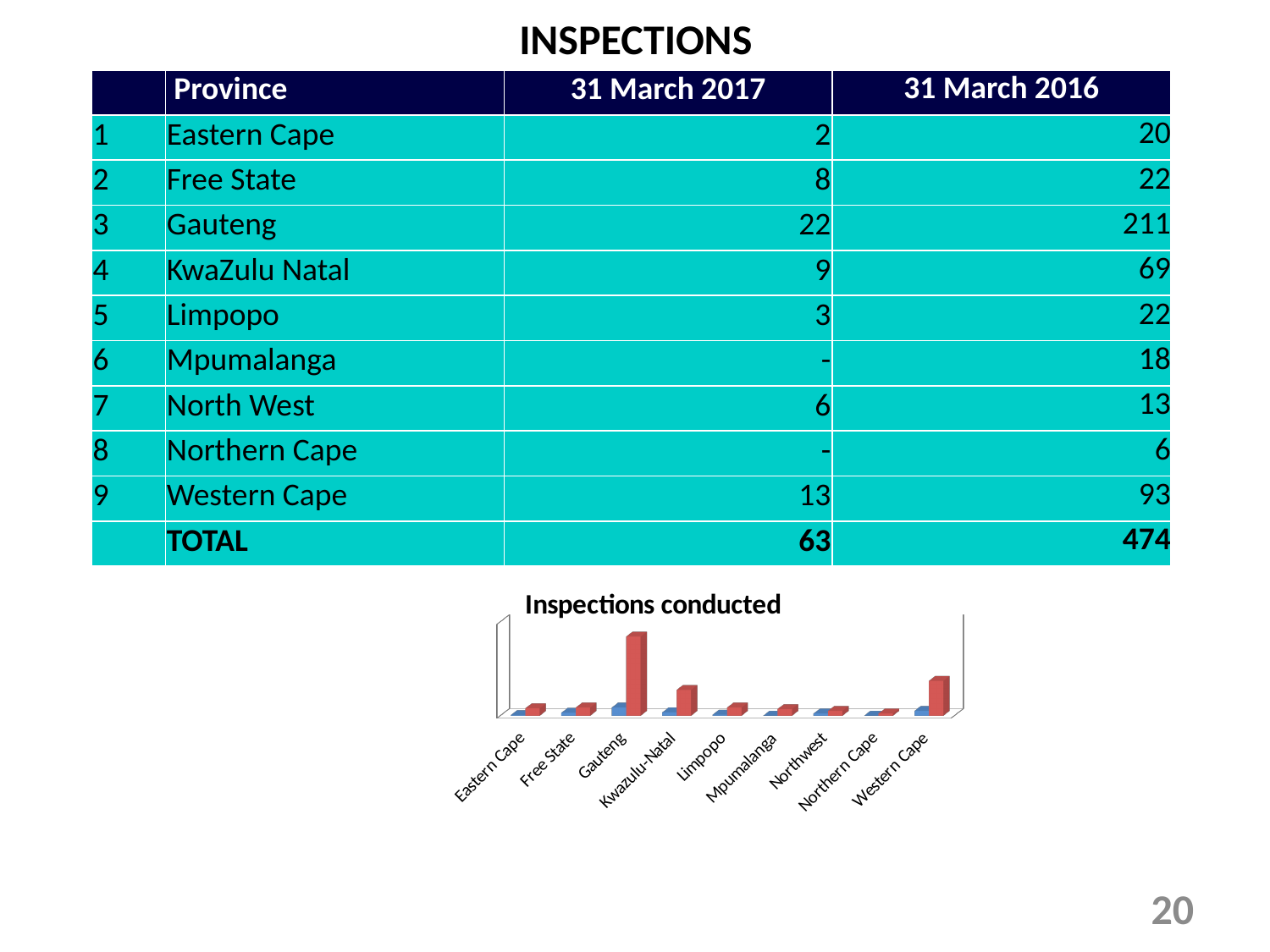
What is the title of the chart on the slide? Inspections conducted In the 'Inspections conducted' chart, is the red bar for Western Cape taller or shorter than the red bar for Limpopo? taller In the 'Inspections conducted' chart, is the red bar for Gauteng taller or shorter than the red bar for Kwazulu-Natal? taller How many bar series are plotted for each province in the 'Inspections conducted' chart? 2 In the 'Inspections conducted' chart, which province has the shortest red bar? Northern Cape In the 'Inspections conducted' chart, is the red bar for Kwazulu-Natal taller or shorter than the red bar for Mpumalanga? taller In the 'Inspections conducted' chart, which colour of bar is taller for every province, blue or red? red In the 'Inspections conducted' chart, which province has the tallest red bar? Gauteng In the 'Inspections conducted' chart, which province has the second tallest red bar? Western Cape Which province is the first category on the x axis of the 'Inspections conducted' chart? Eastern Cape How many provinces are shown on the x axis of the 'Inspections conducted' chart? 9 What kind of chart is the 'Inspections conducted' chart? bar chart